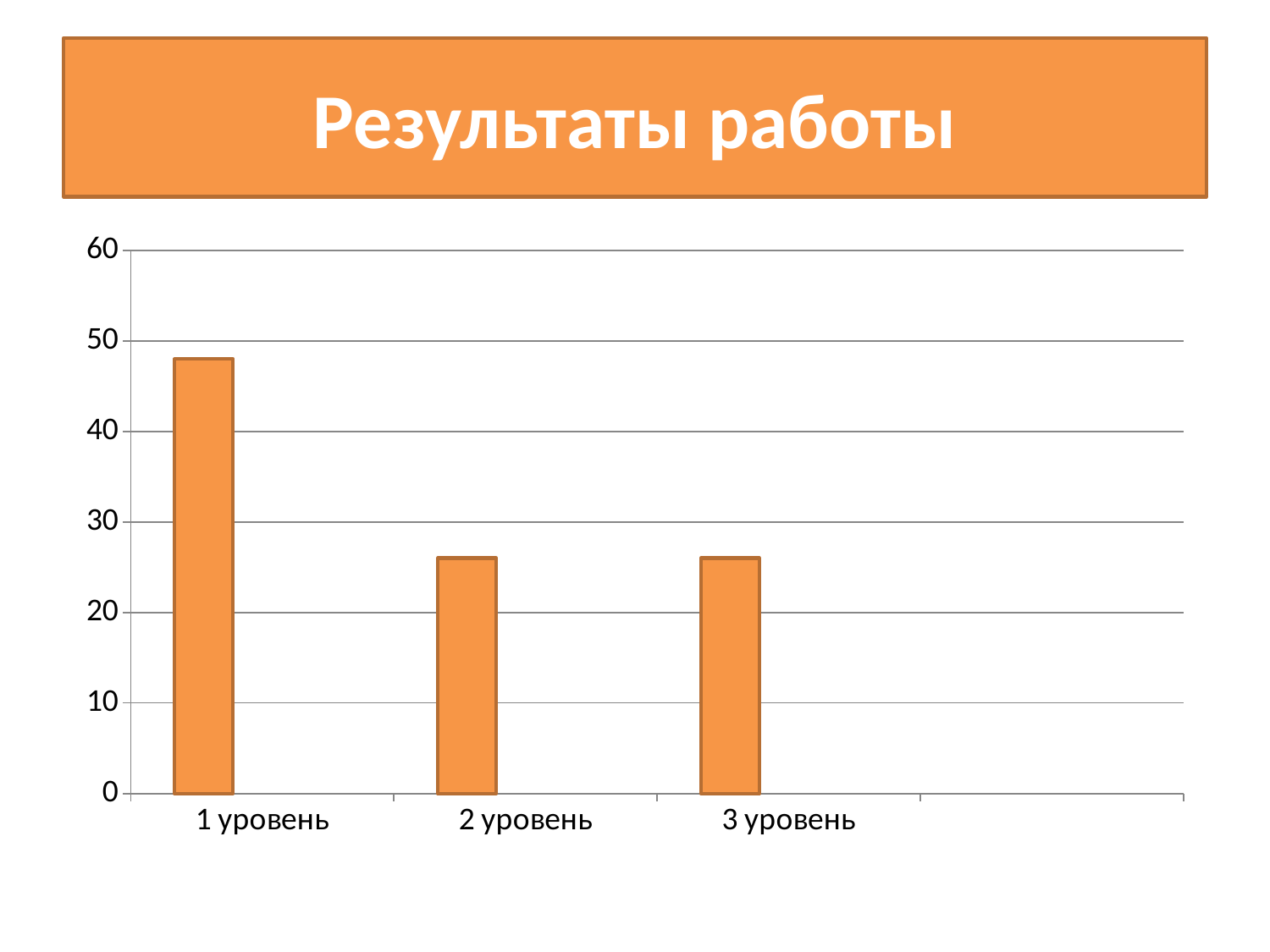
Is the value for 2 уровень greater or less than 30? less What is the title of the slide above the chart? Результаты работы Which is larger, the value for 1 уровень or the value for 3 уровень? 1 уровень Is the value for 1 уровень greater or less than 50? less Which category has the highest value? 1 уровень What kind of chart is shown on the slide? bar chart Is the value for 1 уровень greater or less than 40? greater What is the highest value shown on the vertical axis? 60 How many categories are plotted in the chart? 3 Which is larger, the value for 1 уровень or the value for 2 уровень? 1 уровень